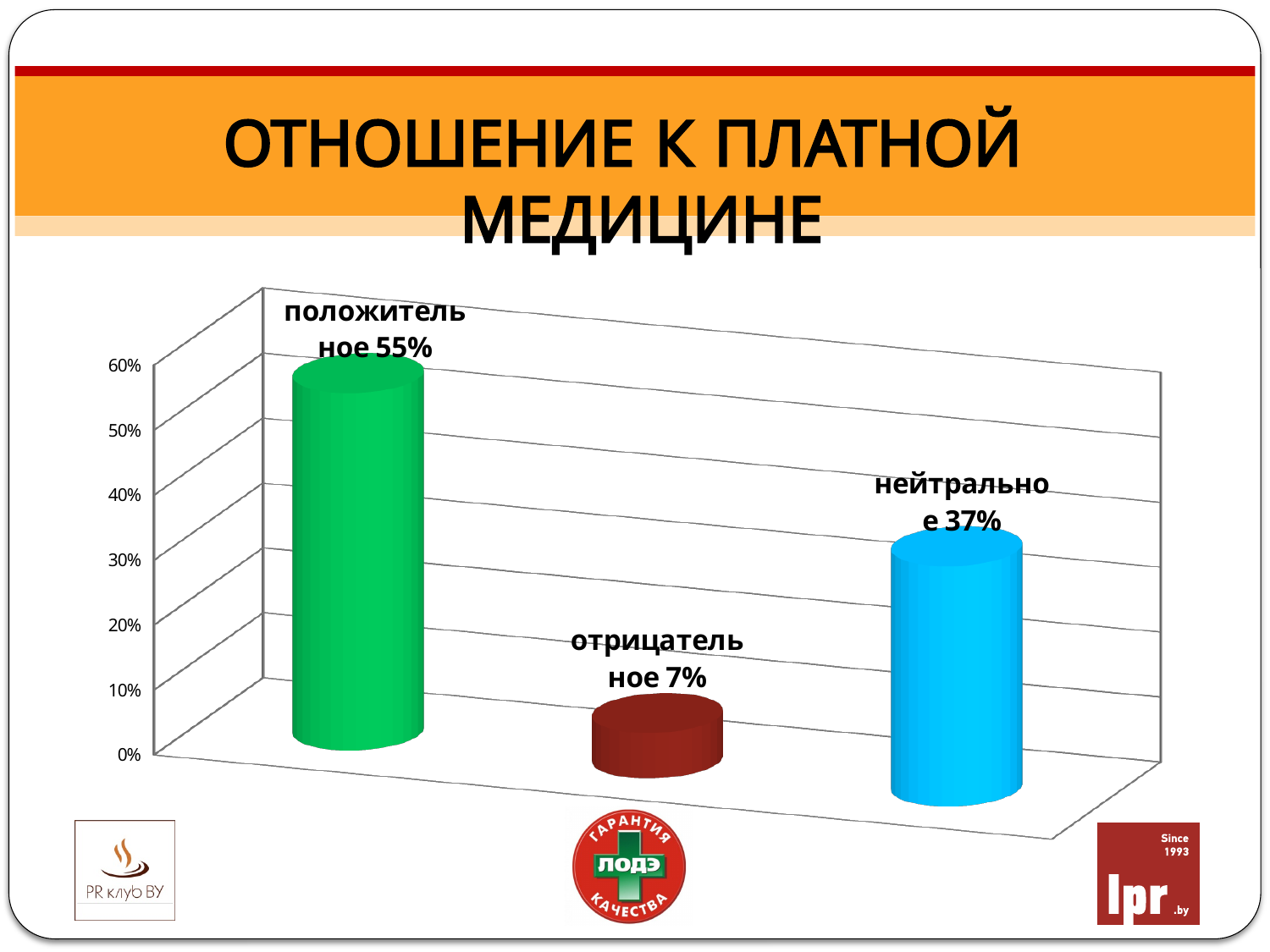
What is the value for нейтральное? 37% How many categories are shown in the chart? 3 Is the value for нейтральное greater or less than 40%? less What is the value for положительное? 55% Which category has the highest value? положительное What is the title of the slide? ОТНОШЕНИЕ К ПЛАТНОЙ МЕДИЦИНЕ Which is larger, the value for нейтральное or the value for отрицательное? нейтральное What is the difference between the values for нейтральное and отрицательное? 30% What is the difference between the values for положительное and нейтральное? 18% What kind of chart is shown on the slide? bar chart Which category has the lowest value? отрицательное What is the value for отрицательное? 7%